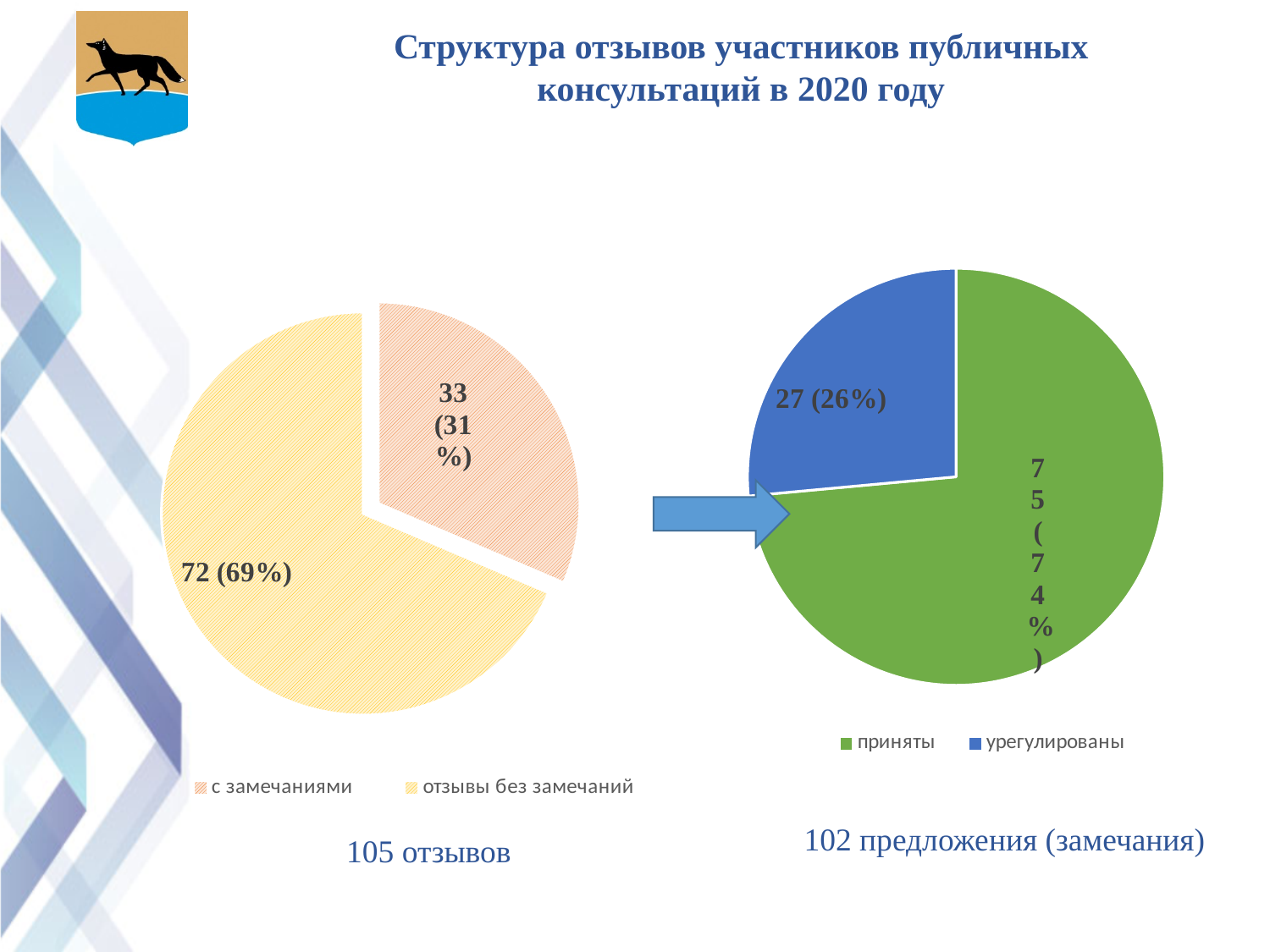
In the left pie chart (105 отзывов), which category has the largest slice? отзывы без замечаний In the right pie chart (102 предложения), what colour is the 'приняты' slice? green In the right pie chart (102 предложения), what is the difference between the number of 'приняты' and 'урегулированы'? 48 In the right pie chart (102 предложения), what share of the pie does 'урегулированы' represent? 26% In the right pie chart (102 предложения), what is the value for 'приняты'? 75 (74%) How many slices does the left pie chart (105 отзывов) have? 2 In the left pie chart (105 отзывов), what is the value for 'отзывы без замечаний'? 72 (69%) In the left pie chart (105 отзывов), what is the value for 'с замечаниями'? 33 (31%) In the right pie chart (102 предложения), what is the value for 'урегулированы'? 27 (26%) In the left pie chart (105 отзывов), what is the difference between the number of 'отзывы без замечаний' and 'с замечаниями'? 39 In the right pie chart (102 предложения), which category has the smallest slice? урегулированы What type of chart is the right chart (102 предложения)? pie chart